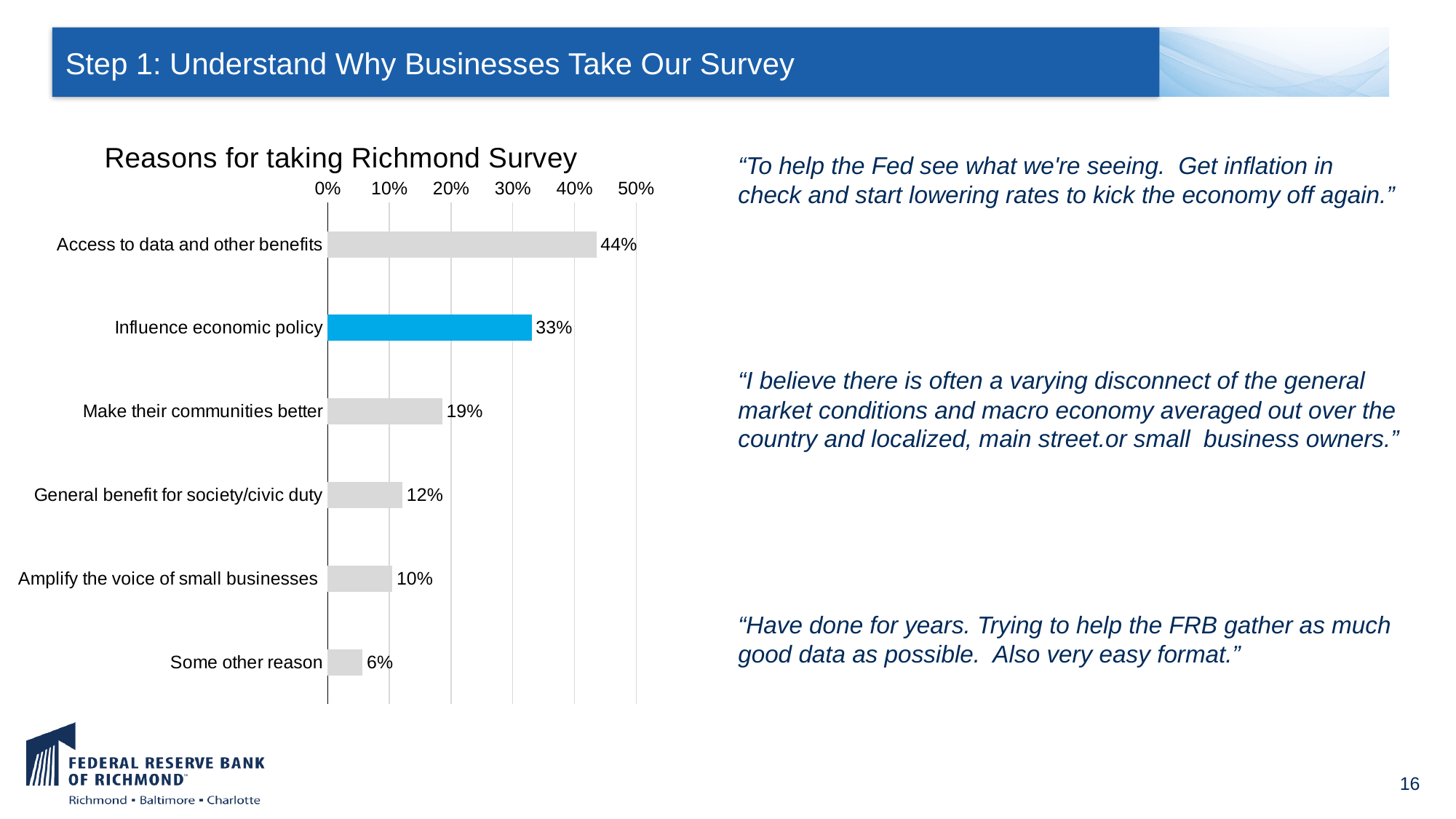
What type of chart is used to show the reasons for taking the Richmond Survey? Bar chart What percentage of respondents cited "Access to data and other benefits" as a reason for taking the Richmond Survey? 44% Which is larger: the value for "Make their communities better" or the value for "General benefit for society/civic duty"? Make their communities better How many reasons (categories) are shown in the chart? 6 Which bar in the chart is highlighted in blue rather than grey? Influence economic policy What is the value shown for "Influence economic policy"? 33% What percentage is shown for "Amplify the voice of small businesses"? 10% What is the difference in percentage points between "Access to data and other benefits" and "Influence economic policy"? 11 percentage points Which reason for taking the Richmond Survey has the highest percentage? Access to data and other benefits Is the value for "Influence economic policy" greater or less than 30%? greater What is the difference between "Make their communities better" and "General benefit for society/civic duty"? 7 percentage points Which reason has the lowest percentage? Some other reason